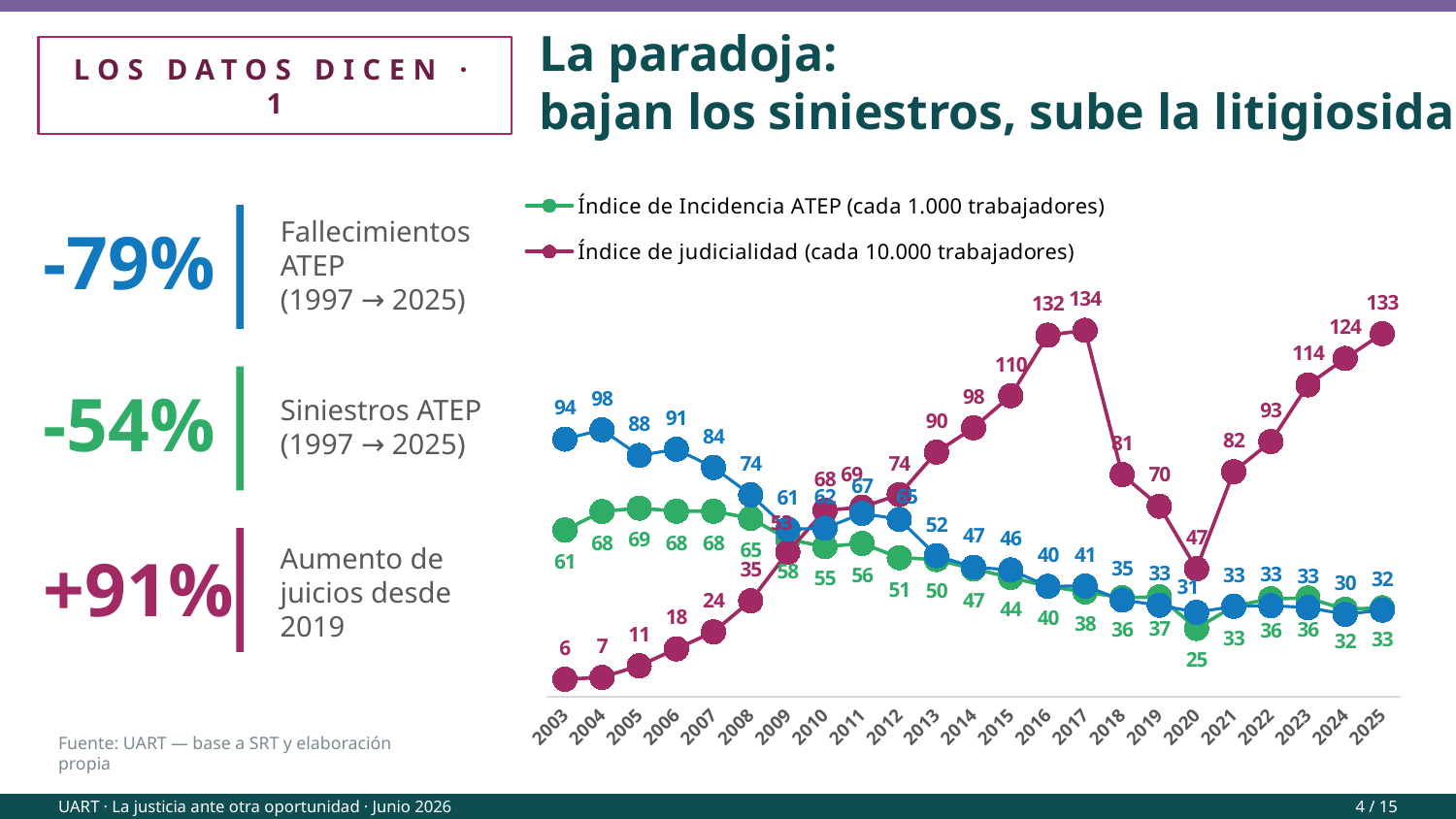
How many years are shown on the x axis of the chart? 23 What is the value of the Índice de judicialidad in 2020? 47 How many series does the chart legend list? 2 What is the value of the Índice de Incidencia ATEP in 2020? 25 In which year is the Índice de judicialidad at its lowest? 2003 What is the difference between the Índice de Incidencia ATEP in 2003 and in 2025? 28 By how much did the Índice de judicialidad increase from 2003 to 2025? 127 In which year does the Índice de judicialidad reach its highest value? 2017 Which is higher for the Índice de Incidencia ATEP: the value in 2005 or the value in 2025? 2005 What is the value of the Índice de judicialidad in 2017? 134 What type of chart is shown on the slide? Line chart In which year is the Índice de Incidencia ATEP at its lowest? 2020